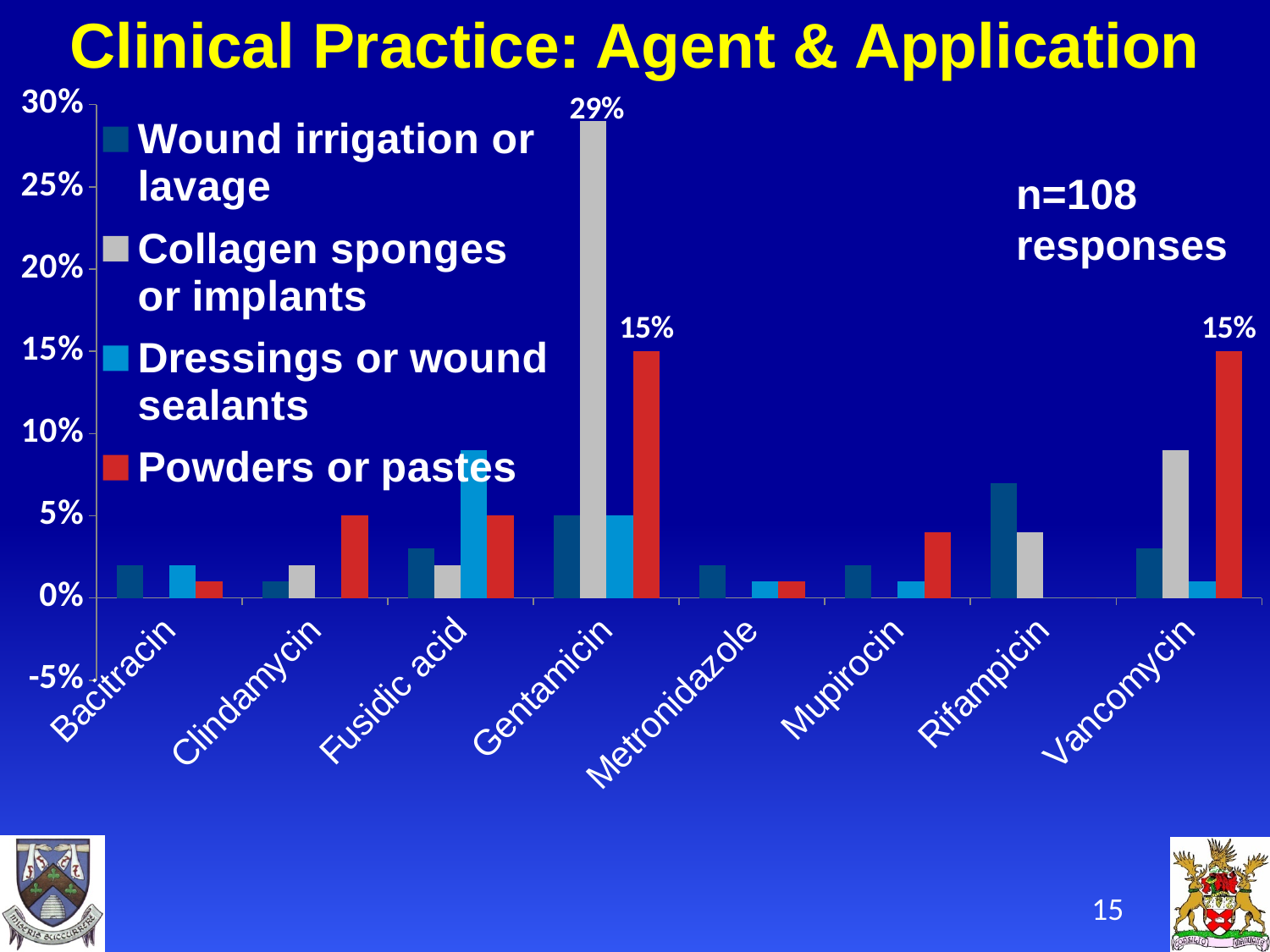
What percentage is shown for Collagen sponges or implants for Gentamicin? 29% What kind of chart is shown on the slide? Bar chart How many responses does the slide say the chart is based on? n=108 responses Which agent has the highest value for Collagen sponges or implants? Gentamicin What is the difference between the Collagen sponges or implants value and the Powders or pastes value for Gentamicin? 14% How many agents are shown on the x axis? 8 How many series does the legend list? 4 Is the value for Dressings or wound sealants for Fusidic acid greater or less than 5%? greater What percentage is shown for Powders or pastes for Gentamicin? 15% Is the value for Wound irrigation or lavage for Rifampicin greater or less than 5%? greater What percentage is shown for Powders or pastes for Vancomycin? 15% For Rifampicin, which is larger: Wound irrigation or lavage, or Collagen sponges or implants? Wound irrigation or lavage